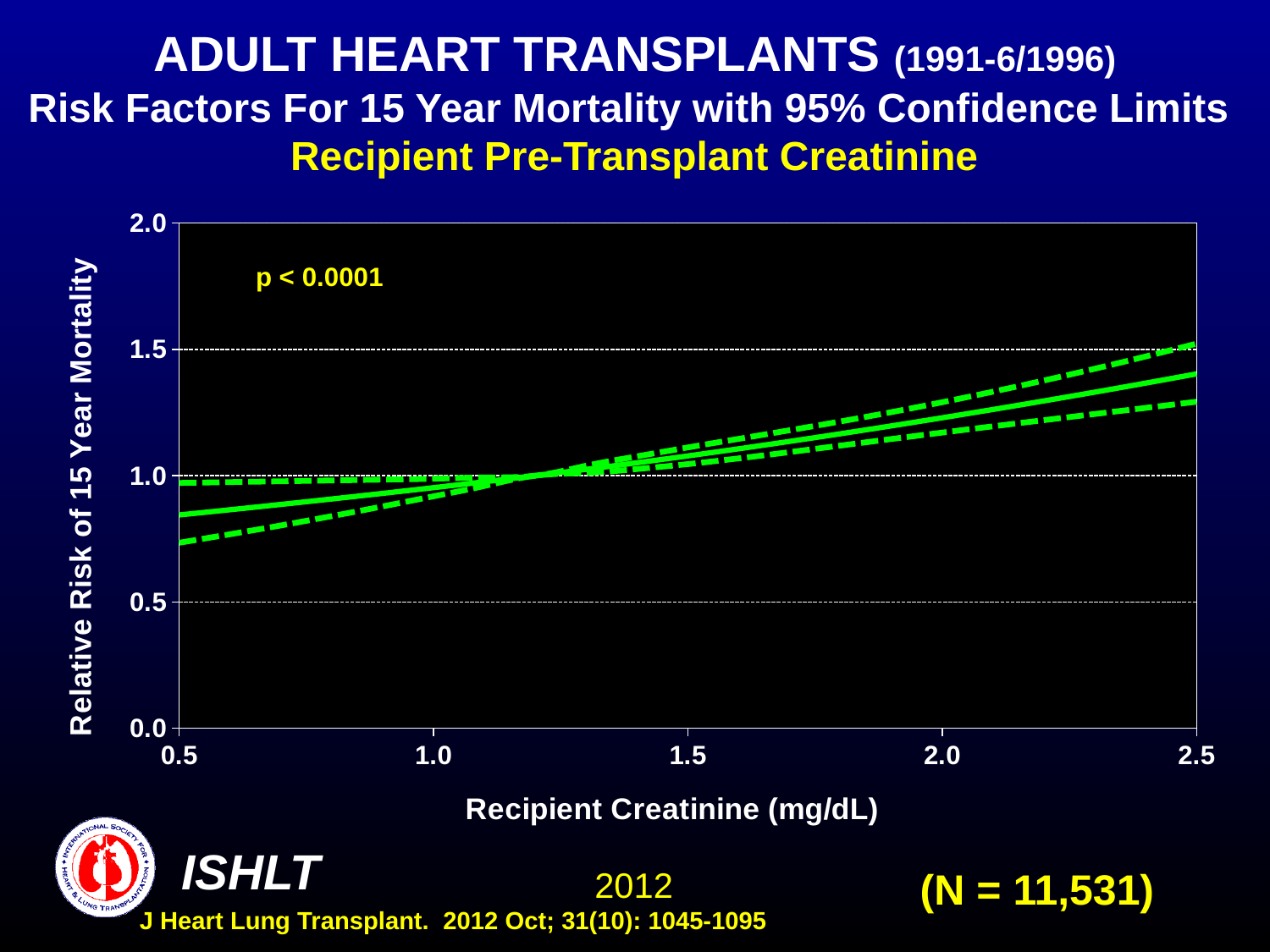
What kind of chart is shown on the slide? line chart How many tick marks are labelled on the x axis of the chart? 5 Is the relative risk of 15 year mortality at a recipient creatinine of 2.0 mg/dL greater or less than 1.0? greater Is the relative risk of 15 year mortality at a recipient creatinine of 2.5 mg/dL greater or less than 1.0? greater Is the relative risk of 15 year mortality (solid line) at a recipient creatinine of 2.5 mg/dL greater or less than 1.5? less How many lines are plotted on the chart (including the confidence limit lines)? 3 Which has the higher relative risk of 15 year mortality: a recipient creatinine of 0.5 mg/dL or 2.5 mg/dL? 2.5 mg/dL Does the relative risk of 15 year mortality rise or fall as recipient creatinine increases from 0.5 to 2.5 mg/dL? rise What is the highest value labelled on the y axis of the chart? 2.0 What p-value is printed on the chart? p < 0.0001